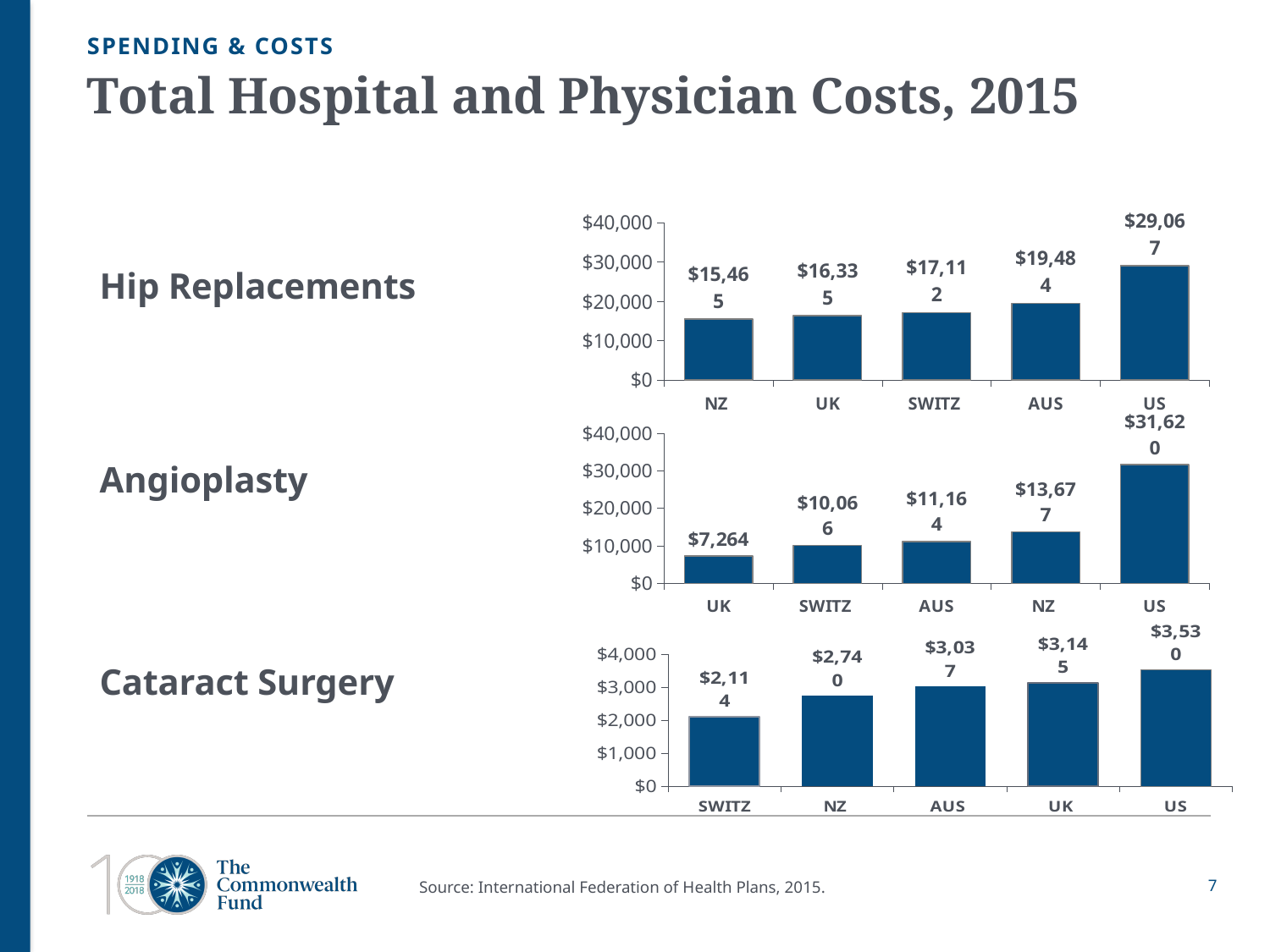
In the Cataract Surgery chart, which is larger, the value for AUS or the value for NZ? AUS In the Hip Replacements chart, what is the difference between the US and AUS values? $9,583 In the Angioplasty chart, what is the value for the UK? $7,264 What type of chart is used for Angioplasty? Bar chart In the Cataract Surgery chart, what is the value for SWITZ? $2,114 How many countries are shown in the Cataract Surgery chart? 5 In the Cataract Surgery chart, what is the difference between the US and UK values? $385 In the Hip Replacements chart, do the values rise or fall from left to right? Rise In the Angioplasty chart, which country has the highest cost? US In the Hip Replacements chart, what is the value for the US? $29,067 In the Hip Replacements chart, which country has the lowest cost? NZ In the Angioplasty chart, is the value for NZ greater or less than $10,000? greater